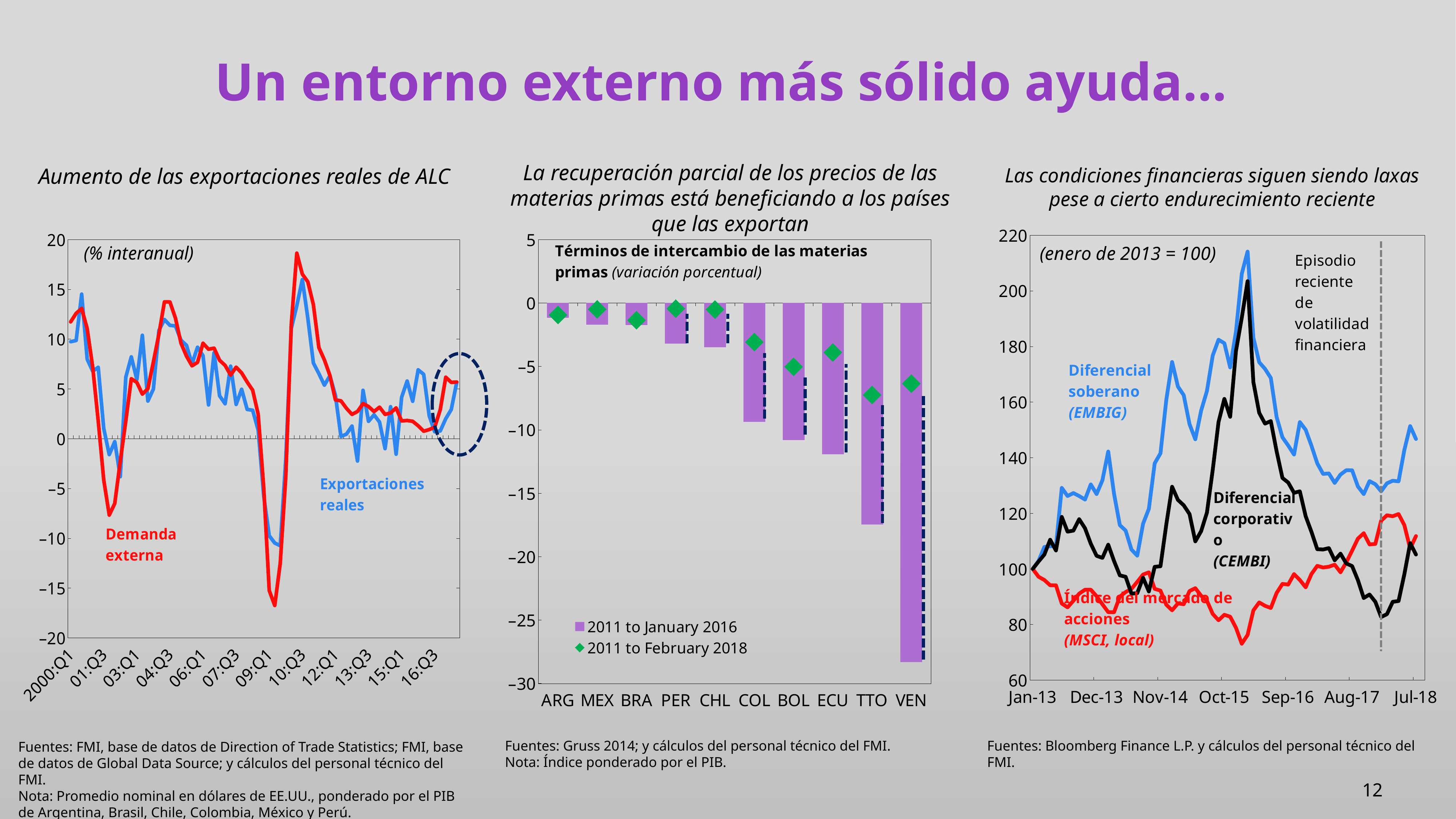
What kind of chart is the left chart, 'Aumento de las exportaciones reales de ALC'? line chart In the middle chart, 'Términos de intercambio de las materias primas', how many series does the legend list? 2 In the middle chart, 'Términos de intercambio de las materias primas', is the 2011 to January 2016 bar for ARG greater or less than -5? greater In the right chart, 'Las condiciones financieras siguen siendo laxas pese a cierto endurecimiento reciente', what base period is the index set to 100? enero de 2013 In the middle chart, 'Términos de intercambio de las materias primas', how many countries are shown on the x axis? 10 In the middle chart, 'Términos de intercambio de las materias primas', is the 2011 to January 2016 bar for VEN greater or less than -25? less In the right chart, 'Las condiciones financieras siguen siendo laxas pese a cierto endurecimiento reciente', is the peak of the Diferencial soberano (EMBIG) line greater or less than 200? greater In the middle chart, 'Términos de intercambio de las materias primas', which is more negative for 2011 to January 2016: ECU or PER? ECU In the middle chart, 'Términos de intercambio de las materias primas', which country has the lowest (most negative) bar for 2011 to January 2016? VEN What kind of chart is the middle chart, 'Términos de intercambio de las materias primas'? bar chart In the left chart, 'Aumento de las exportaciones reales de ALC', what are the two series shown? Exportaciones reales and Demanda externa